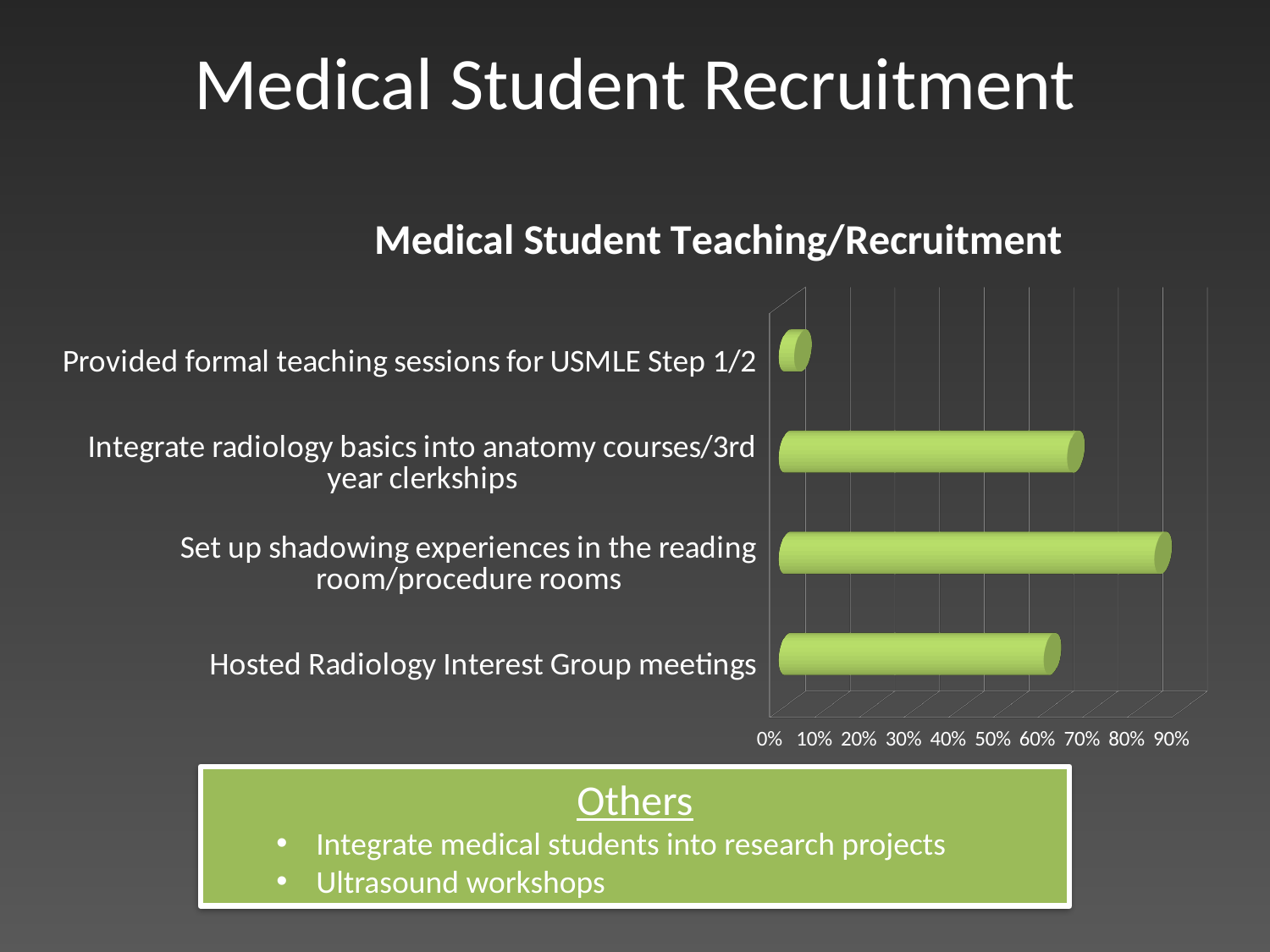
Is the value for "Hosted Radiology Interest Group meetings" greater or less than 50%? greater How many categories are plotted in the chart? 4 What type of chart is shown on the slide? Bar chart Is the value for "Set up shadowing experiences in the reading room/procedure rooms" greater or less than 80%? greater Is the value for "Integrate radiology basics into anatomy courses/3rd year clerkships" greater or less than 60%? greater Which is larger: the value for "Provided formal teaching sessions for USMLE Step 1/2" or for "Integrate radiology basics into anatomy courses/3rd year clerkships"? Integrate radiology basics into anatomy courses/3rd year clerkships What is the title of the chart? Medical Student Teaching/Recruitment Which category has the lowest value? Provided formal teaching sessions for USMLE Step 1/2 Which category has the highest value? Set up shadowing experiences in the reading room/procedure rooms What is the highest percentage tick shown on the horizontal axis? 90% Which is larger: the value for "Set up shadowing experiences in the reading room/procedure rooms" or for "Hosted Radiology Interest Group meetings"? Set up shadowing experiences in the reading room/procedure rooms